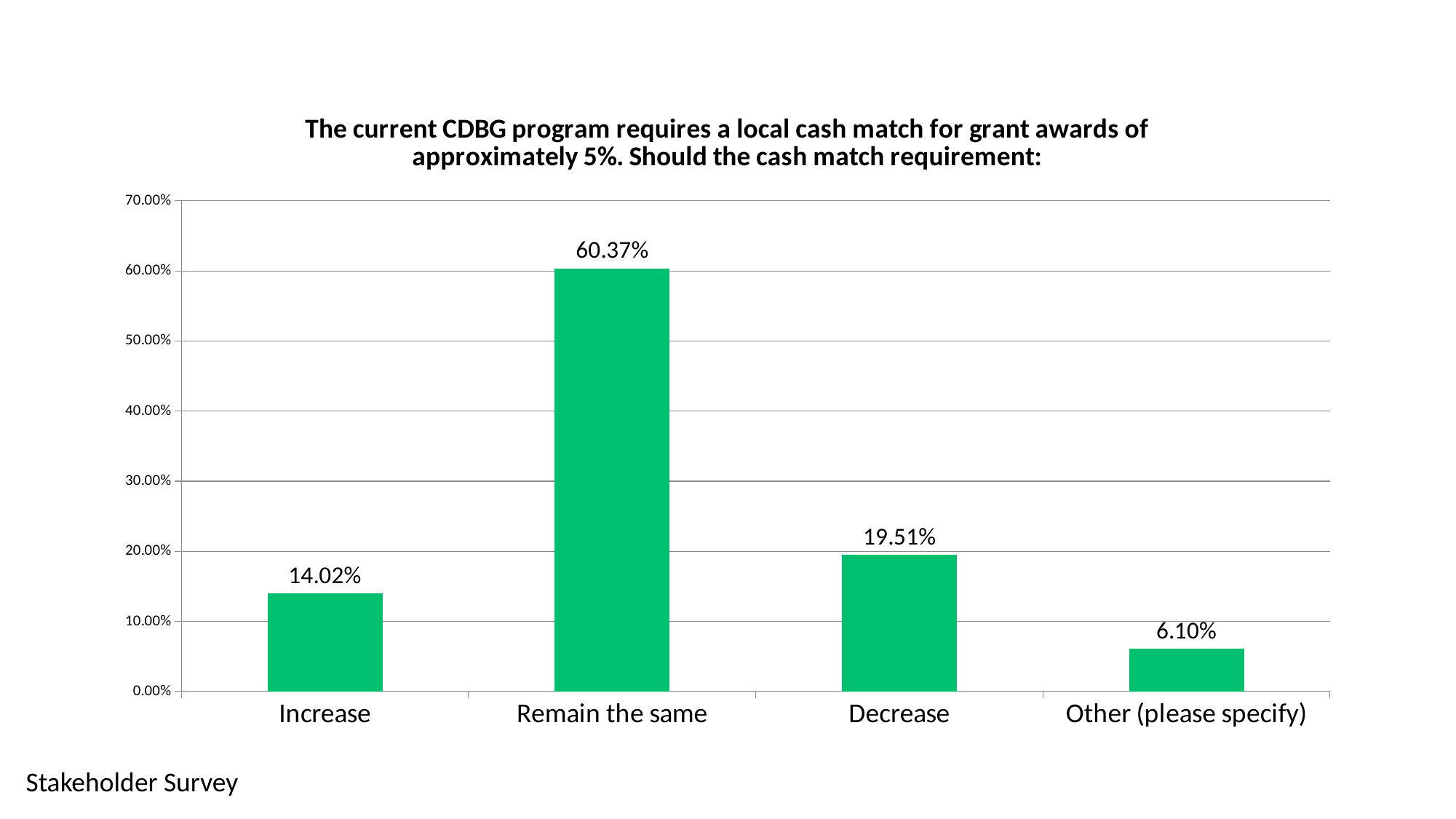
What is the difference between the Decrease and Increase values? 5.49% What is the value shown for the Increase category? 14.02% Which category has the highest value? Remain the same What is the text shown at the bottom left of the slide? Stakeholder Survey Which is larger, the value for Increase or the value for Decrease? Decrease How many categories are shown on the x axis? 4 What percentage of respondents said the cash match requirement should remain the same? 60.37% What is the value for Other (please specify)? 6.10% What is the difference between the Remain the same and Decrease values? 40.86% What kind of chart is shown on the slide? Bar chart Which category has the lowest value? Other (please specify) What percentage of respondents chose Decrease? 19.51%